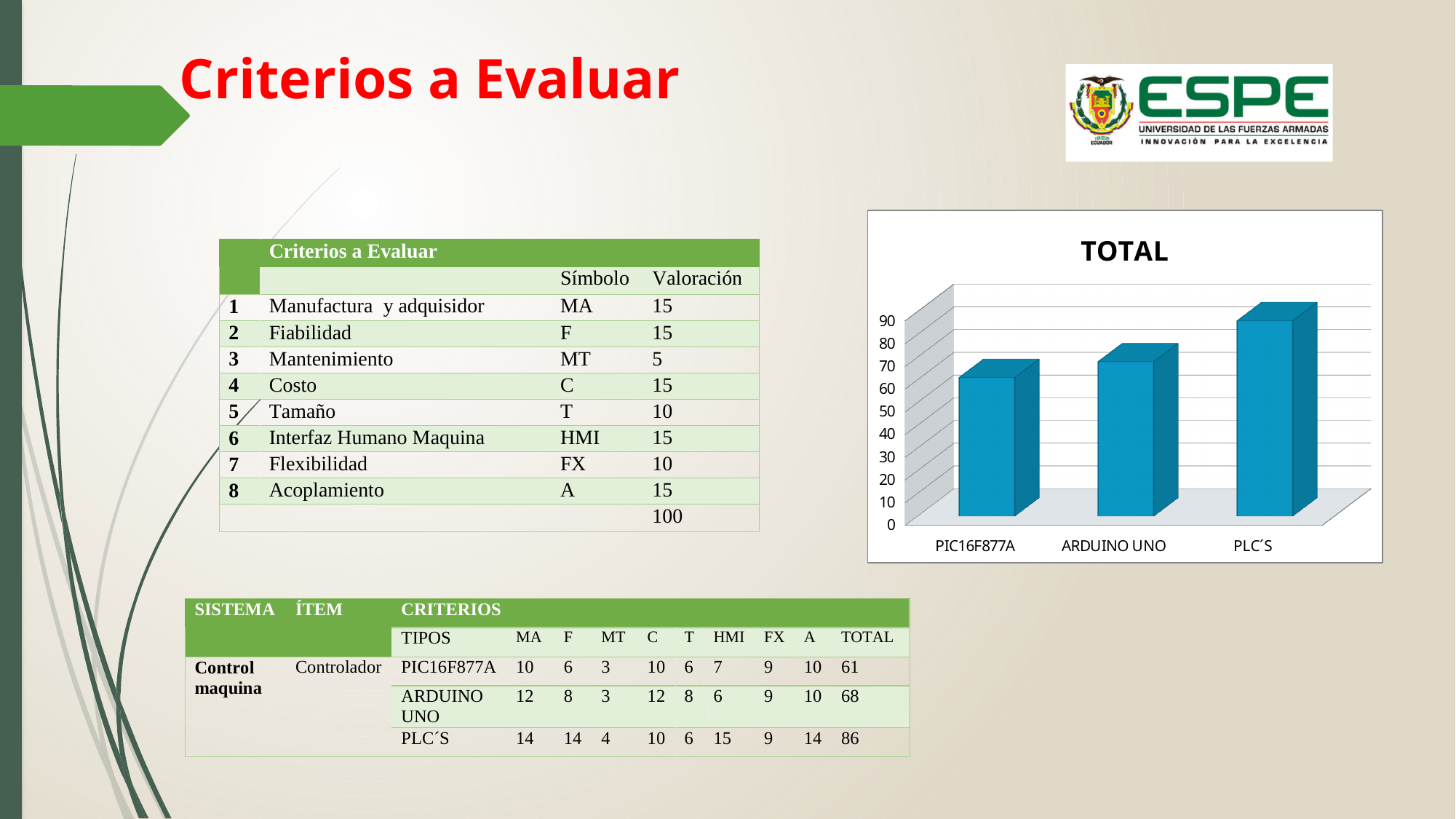
Do the bar values rise or fall from left to right across the TOTAL chart? rise Which is larger in the TOTAL chart, the value for PLC´S or the value for ARDUINO UNO? PLC´S Is the value for ARDUINO UNO greater or less than 80? less Is the value for PLC´S greater or less than 80? greater What is the highest value shown on the vertical axis of the TOTAL chart? 90 What is the title of the chart? TOTAL How many categories are plotted in the TOTAL chart? 3 Which category has the highest bar in the TOTAL chart? PLC´S Is the value for PIC16F877A greater or less than 50? greater Which category has the lowest bar in the TOTAL chart? PIC16F877A What kind of chart is shown on the slide? bar chart